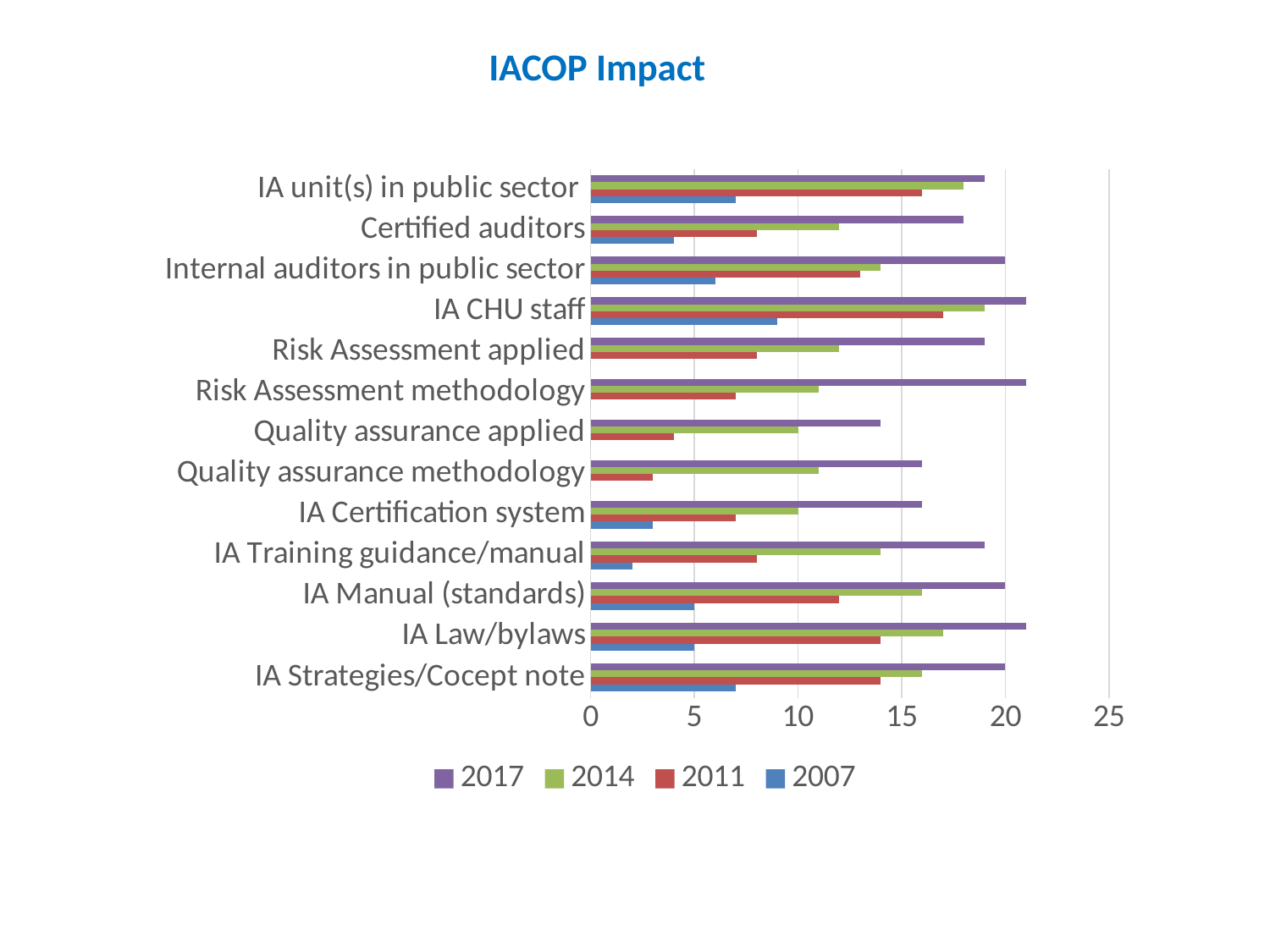
Is the 2011 value for Quality assurance methodology greater or less than 5? less Is the 2017 value for Quality assurance applied greater or less than 10? greater How many categories are listed on the vertical axis of the chart? 13 For IA CHU staff, which series has the larger value, 2017 or 2007? 2017 What kind of chart is shown on the slide? bar chart How many series does the legend list? 4 What is the title of the chart? IACOP Impact Is the 2014 value for IA unit(s) in public sector greater or less than 15? greater Which years are listed in the chart legend? 2017, 2014, 2011, 2007